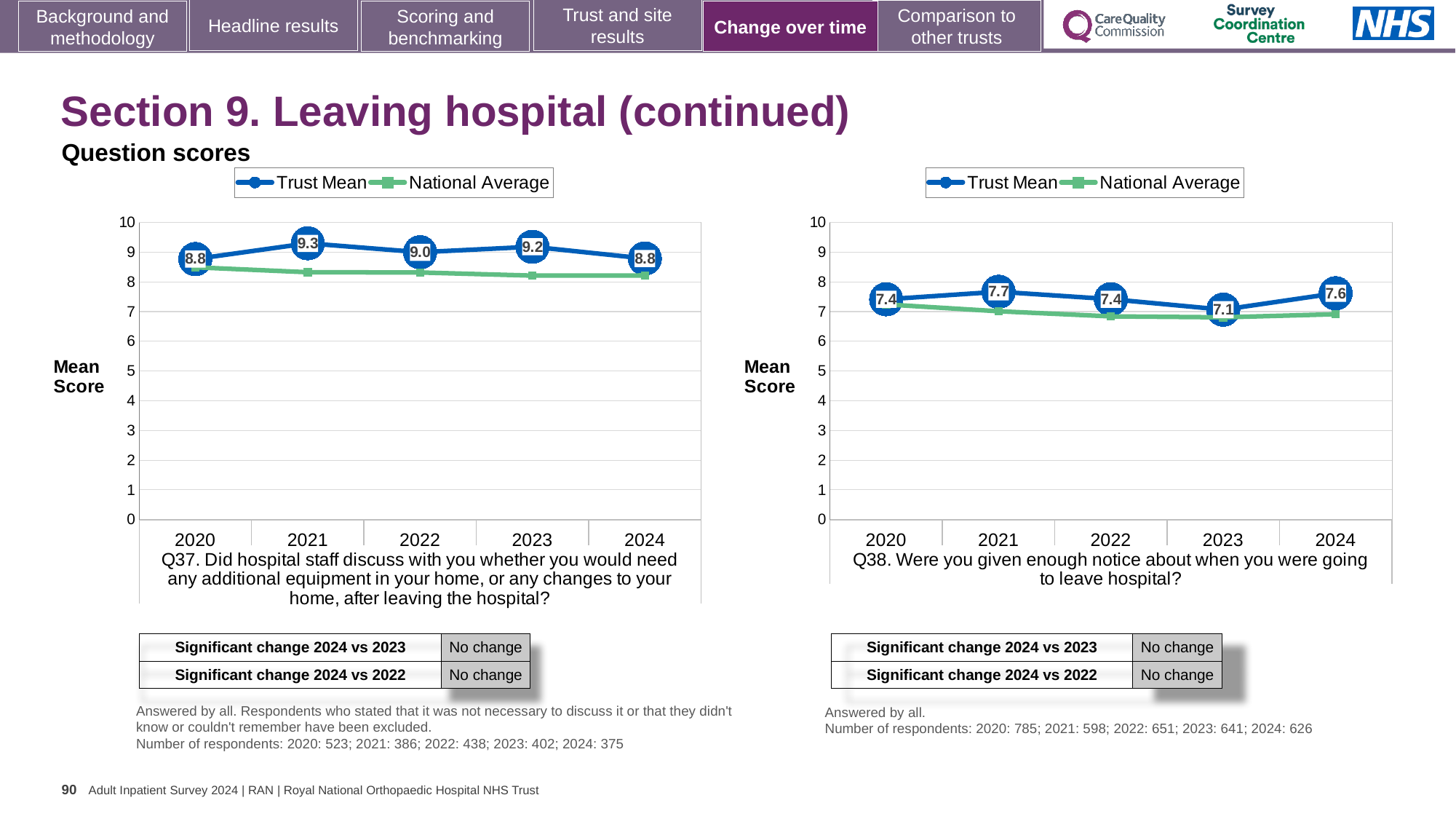
In the Q38 chart on the right, is the National Average value for 2023 greater or less than 8? less In the Q37 chart on the left, what is the difference between the Trust Mean scores for 2021 and 2022? 0.3 How many years are plotted on the x axis of the Q37 chart on the left? 5 In the Q37 chart on the left, what is the Trust Mean score for 2024? 8.8 In the Q37 chart on the left, what is the Trust Mean score for 2021? 9.3 In the Q37 chart on the left, which year has the highest Trust Mean score? 2021 In the Q38 chart on the right, what is the Trust Mean score for 2023? 7.1 In the Q38 chart on the right, what is the Trust Mean score for 2024? 7.6 What kind of chart is the Q37 chart on the left? line chart In the Q38 chart on the right, which year has the lowest Trust Mean score? 2023 In the Q38 chart on the right, is the Trust Mean score for 2021 larger or smaller than the score for 2023? larger How many series does the legend of the Q38 chart on the right list? 2